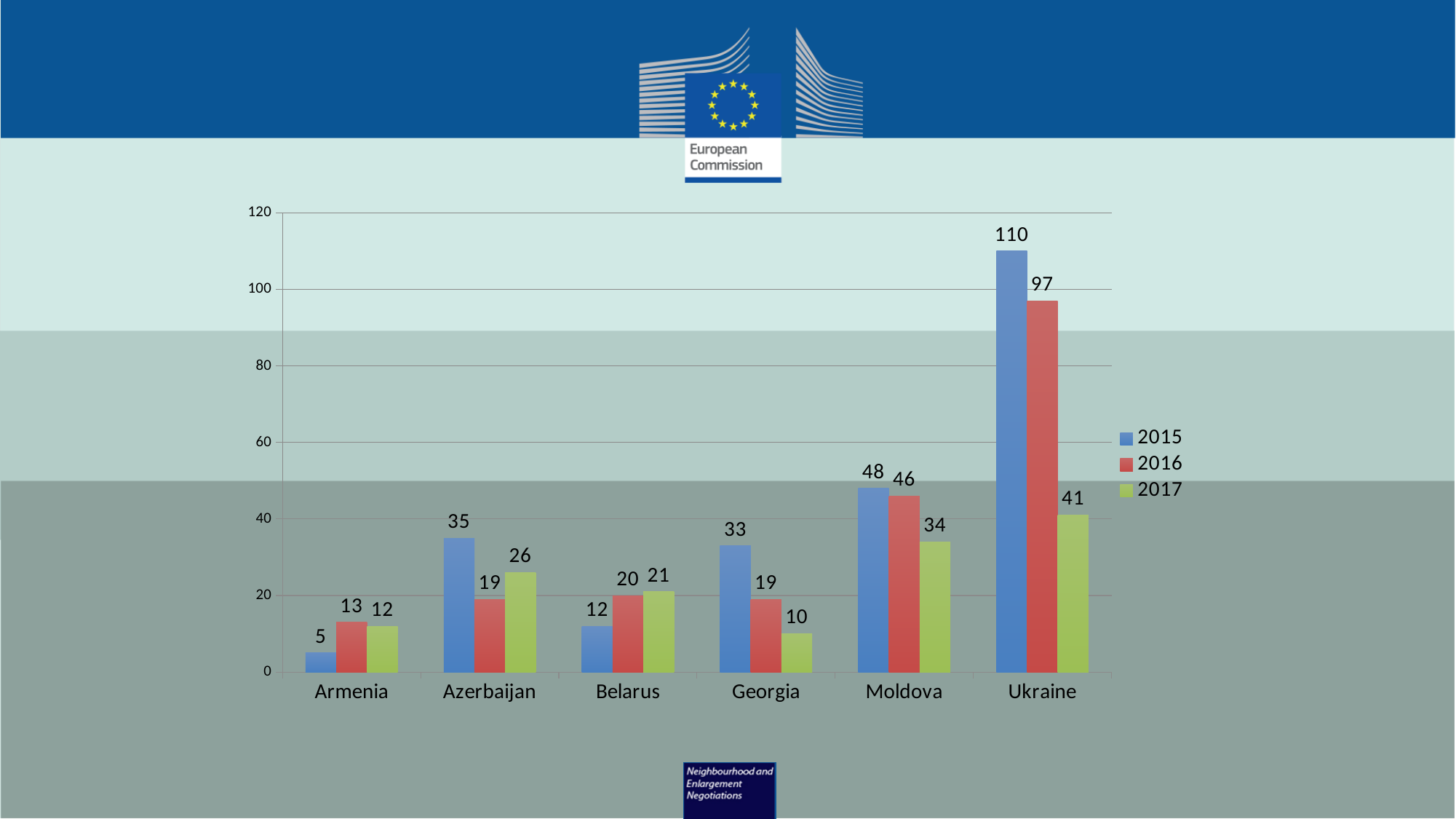
What kind of chart is shown on the slide? Bar chart What is the value for Georgia in 2017? 10 Which country has the lowest value in 2015? Armenia Which country has the highest value in 2016? Ukraine What is the difference between Ukraine's 2015 and 2016 values? 13 What is the value for Belarus in 2016? 20 Is the value for Moldova in 2015 greater or less than 40? greater Which colour represents the 2017 series in the legend? Green How many series does the legend list? 3 How many countries are shown on the x axis? 6 What is the value for Ukraine in 2015? 110 Which is larger: Azerbaijan's 2017 value or Belarus's 2017 value? Azerbaijan's 2017 value